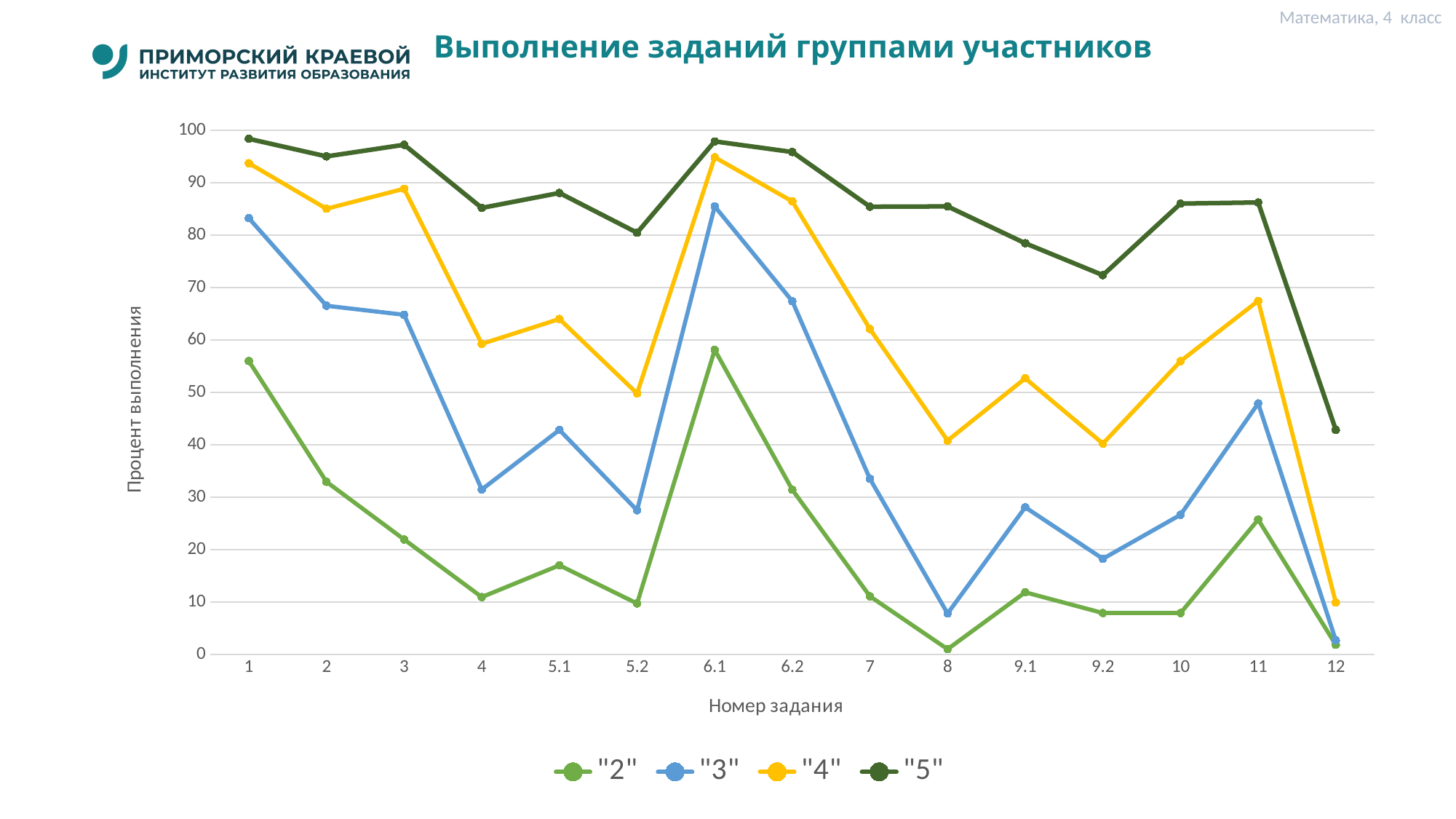
At task 4, which series has the larger value, "3" or "4"? "4" What is the label of the vertical axis? Процент выполнения How many task numbers are shown along the x axis? 15 Is the value for series "4" at task 8 greater or less than 50? less Does the value for series "2" rise or fall from task 1 to task 4? fall Is the value for series "5" at task 12 greater or less than 50? less What is the title of the chart? Выполнение заданий группами участников For series "4", which task has the lowest value? 12 How many series does the legend list? 4 What kind of chart is shown on the slide? line chart Is the value for series "2" at task 1 greater or less than 50? greater For series "5", which task has the lowest value? 12